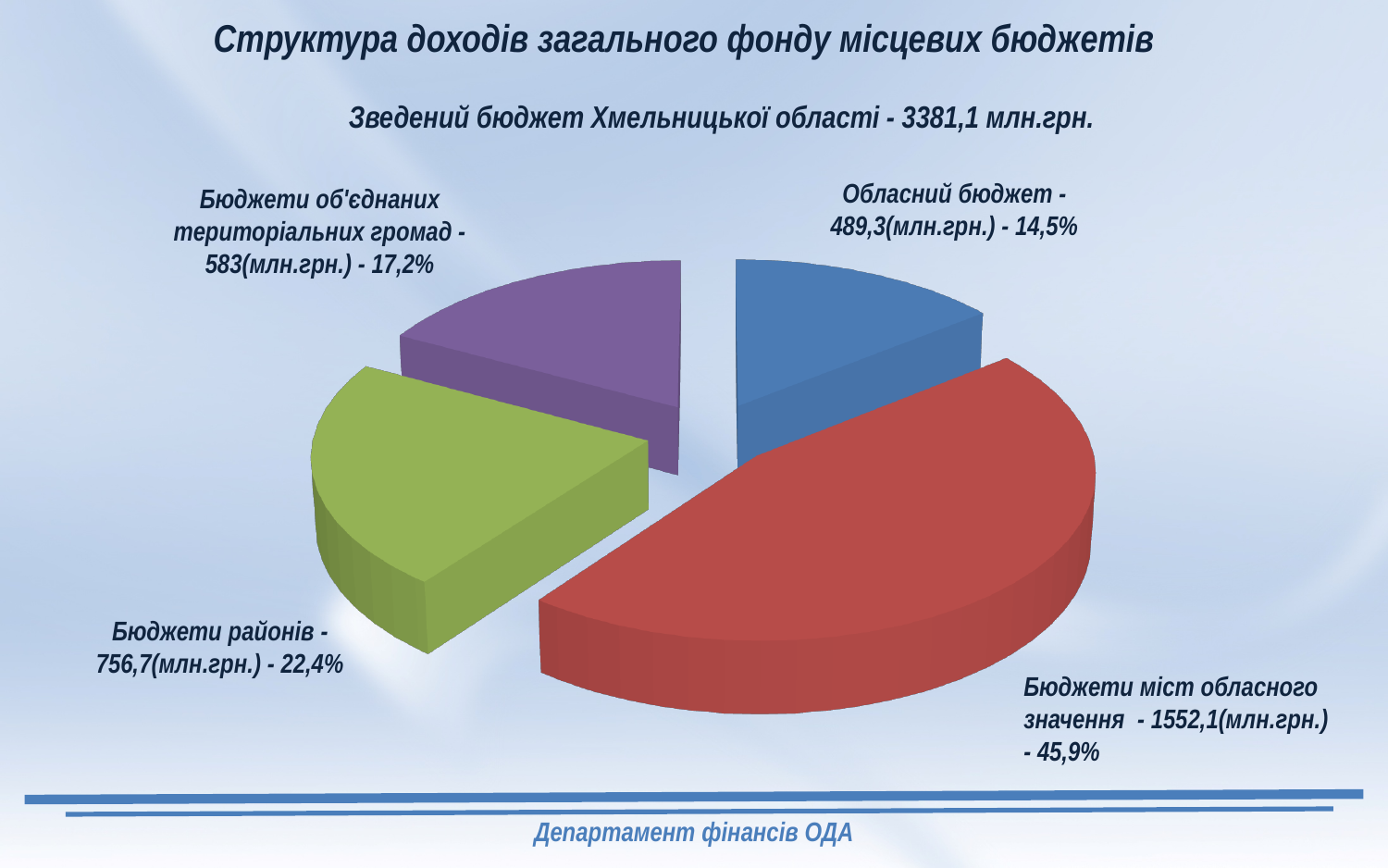
Which category has the smallest slice of the pie? Обласний бюджет What percentage share is shown for Бюджети об'єднаних територіальних громад? 17,2% What type of chart is shown on the slide? pie chart What is the value for Обласний бюджет? 489,3(млн.грн.) What is the difference in percentage points between Бюджети районів (22,4%) and Обласний бюджет (14,5%)? 7,9 Which is larger: Бюджети районів or Бюджети об'єднаних територіальних громад? Бюджети районів What share of the pie does Бюджети міст обласного значення represent? 45,9% Which category has the largest slice of the pie? Бюджети міст обласного значення What is the value for Бюджети районів? 756,7(млн.грн.) What total value for the consolidated budget of Хмельницька область is stated on the slide? 3381,1 млн.грн. What colour is the slice for Бюджети міст обласного значення? red How many slices does the pie chart have? 4